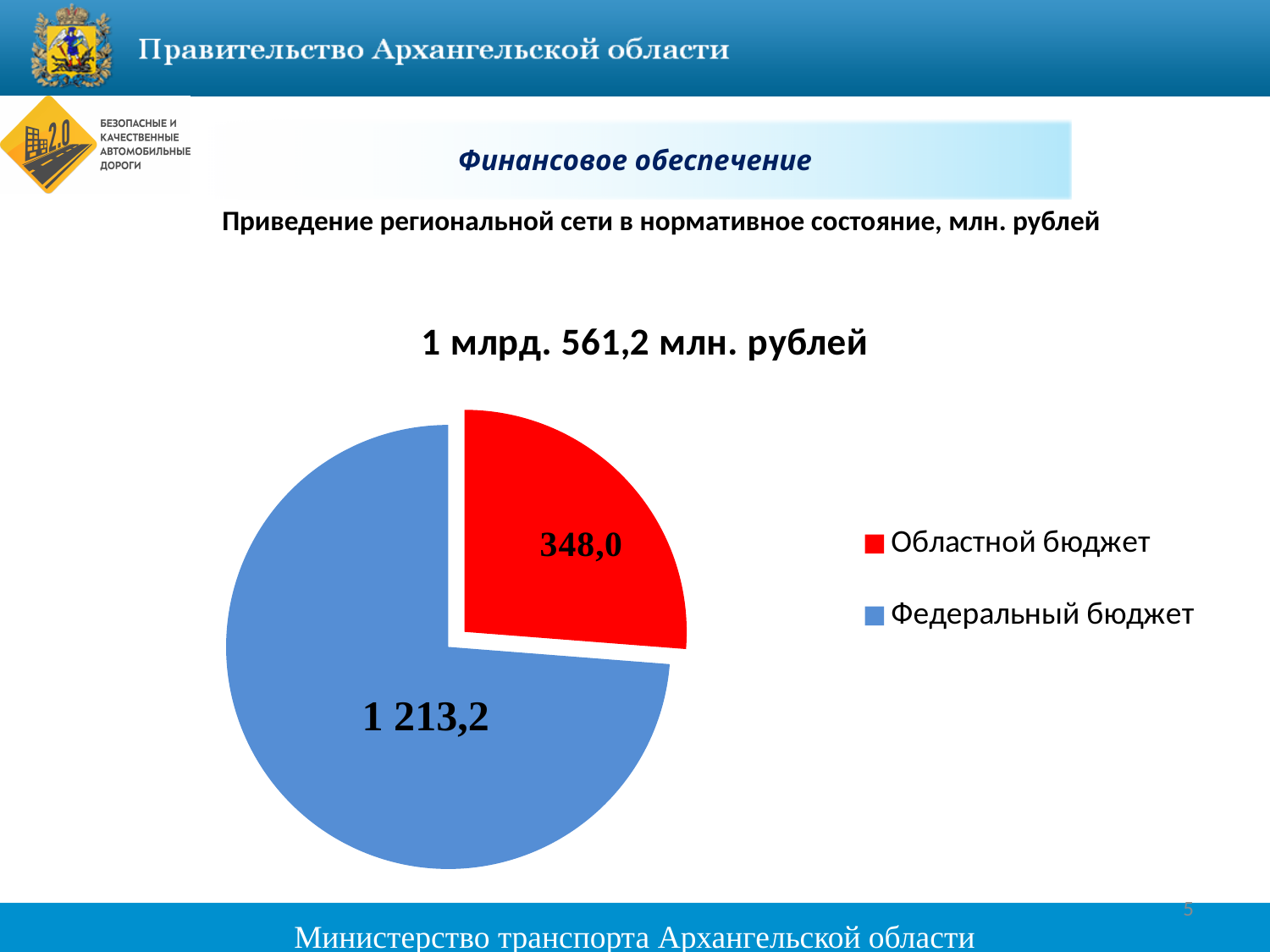
What is the value for Областной бюджет in the pie chart? 348,0 What colour is the Областной бюджет slice? red Which slice of the pie chart is the smallest? Областной бюджет What is the difference between the Федеральный бюджет and Областной бюджет values? 865,2 What is the total of the two slices shown in the pie chart? 1 561,2 How many slices does the pie chart have? 2 What is the title shown above the pie chart? 1 млрд. 561,2 млн. рублей Which slice of the pie chart is the largest? Федеральный бюджет What is the value for Федеральный бюджет in the pie chart? 1 213,2 What type of chart is shown on the slide? pie chart Which is larger, Областной бюджет or Федеральный бюджет? Федеральный бюджет How many entries does the legend list? 2